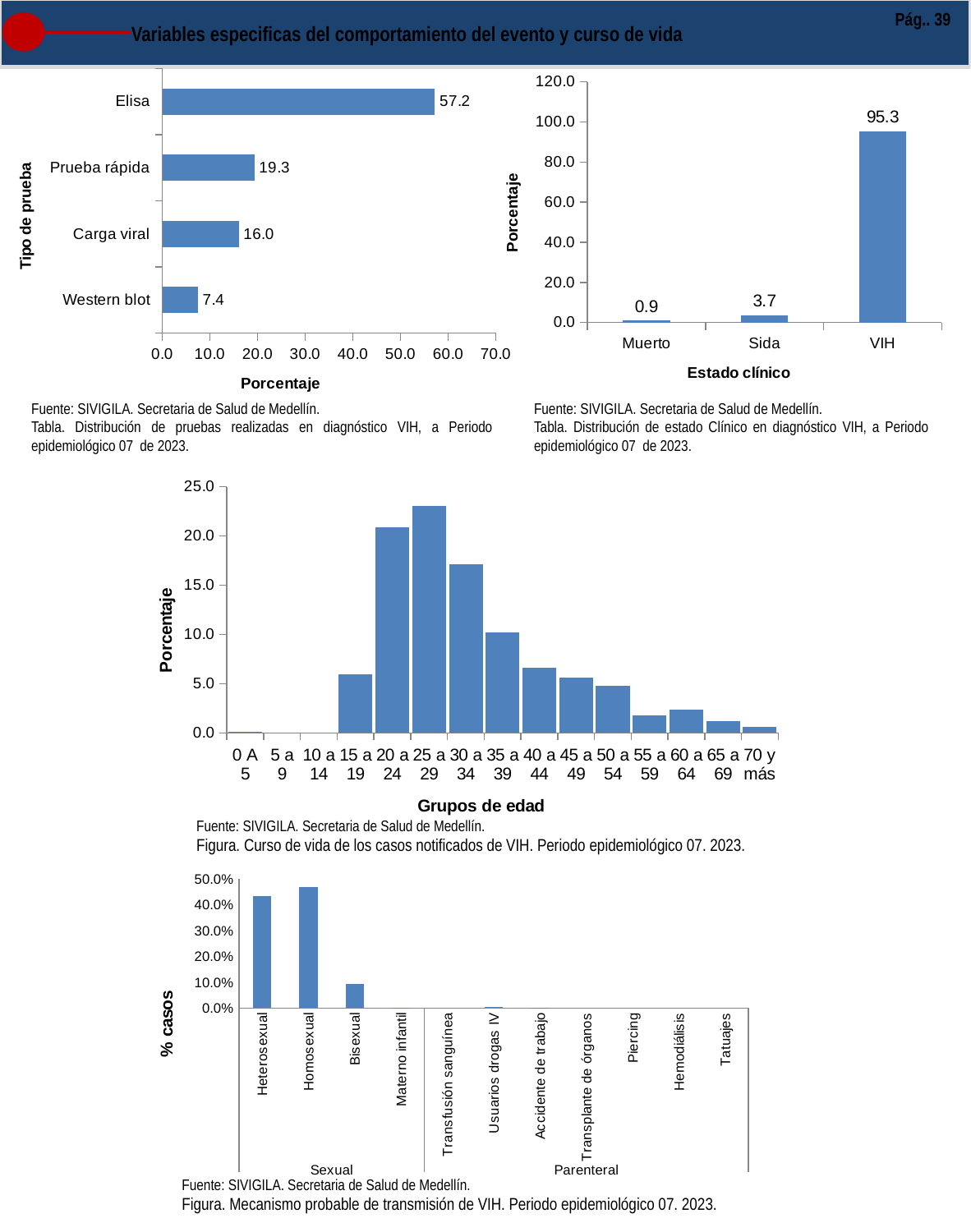
In the middle chart (Grupos de edad), how many age groups are shown on the x axis? 15 In the middle chart (Grupos de edad), which age group has the highest percentage? 25 a 29 In the top-left chart (Tipo de prueba), which test type has the lowest percentage? Western blot In the top-left chart (Tipo de prueba), what is the difference between Prueba rápida and Carga viral? 3.3 In the top-right chart (Estado clínico), what is the value for Sida? 3.7 In the bottom chart (% casos by transmission mechanism), which category has the highest value? Homosexual In the top-right chart (Estado clínico), which category has the highest percentage? VIH In the top-left chart (Tipo de prueba), how many test types are shown? 4 In the top-left chart (Tipo de prueba), what is the value for Elisa? 57.2 In the top-right chart (Estado clínico), what is the difference between VIH and Muerto? 94.4 In the middle chart (Grupos de edad), is the value for 20 a 24 greater or less than 20.0? greater In the bottom chart (% casos by transmission mechanism), is the value for Heterosexual greater or less than 40.0%? greater